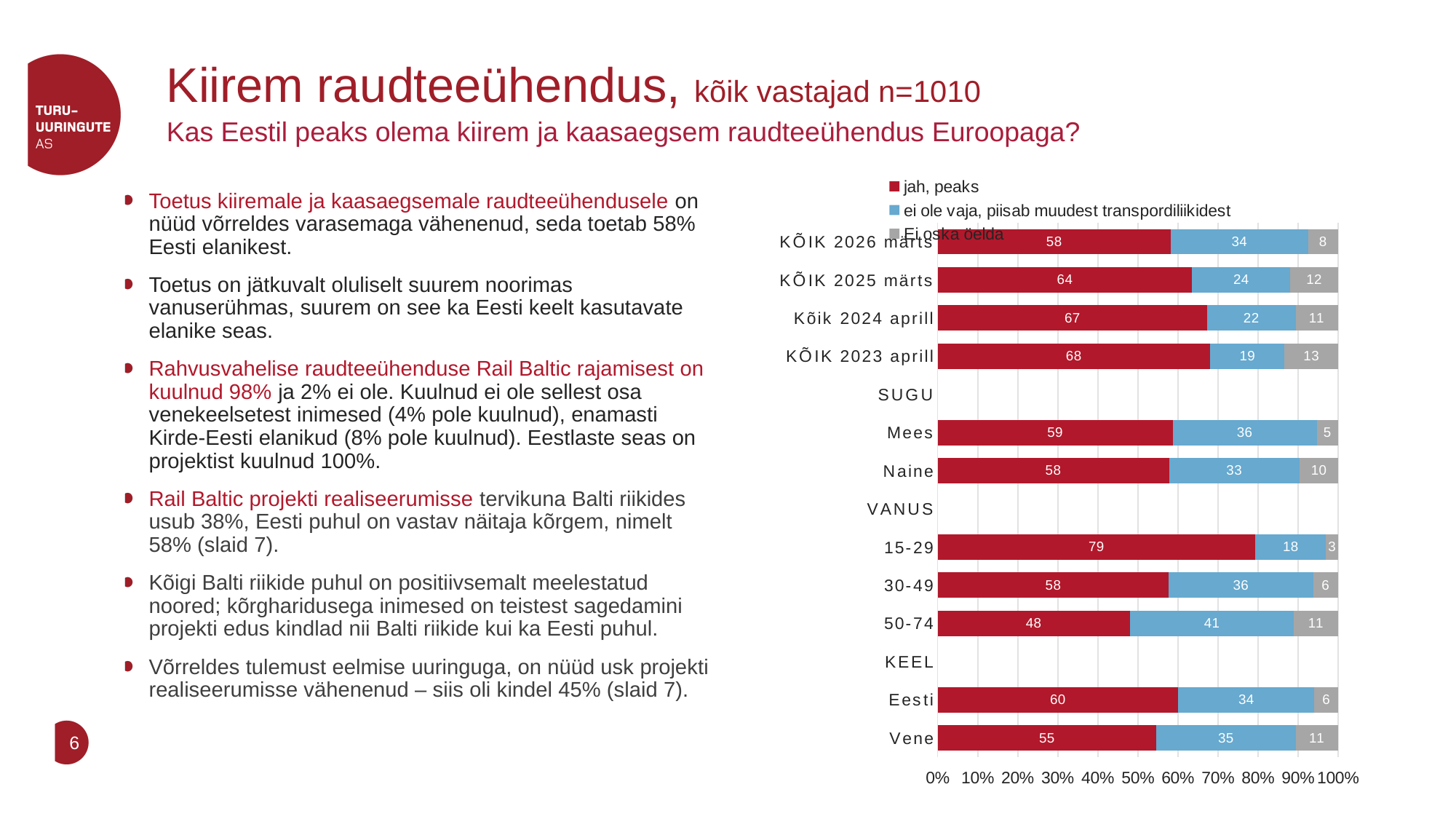
What is the "Ei oska öelda" value for KÕIK 2023 aprill? 13 What kind of chart is shown on the slide? Stacked bar chart Which colour represents the "jah, peaks" series? Red What is the value of "jah, peaks" for the 15-29 age group? 79 What is the difference between the "jah, peaks" values for KÕIK 2023 aprill and KÕIK 2026 märts? 10 What is the total of the stacked bar for Mees? 100 How many series does the legend list? 3 What is the "jah, peaks" value for Vene? 55 Which has a larger "jah, peaks" value, Eesti or Vene? Eesti Which category has the lowest "jah, peaks" value? 50-74 What is the value of "ei ole vaja, piisab muudest transpordiliikidest" for the 50-74 age group? 41 Which category has the highest "jah, peaks" value? 15-29